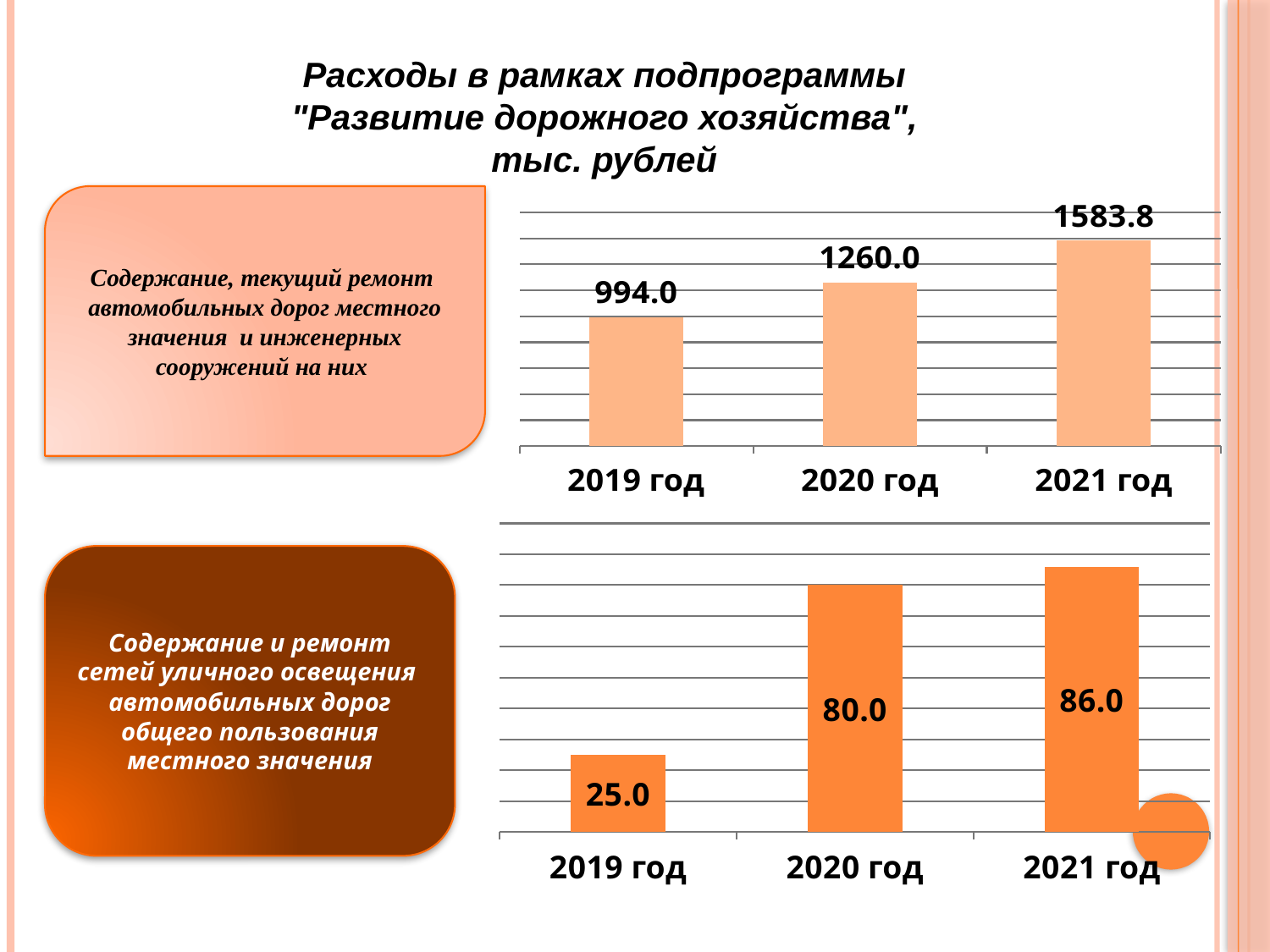
In the top chart, what is the difference between the values for 2021 год and 2020 год? 323.8 In the bottom chart, do the values rise or fall from 2019 год to 2021 год? rise In the bottom chart, which year has the lowest value? 2019 год In the top chart, which year has the highest value? 2021 год How many bars are in the bottom chart? 3 In the top chart, which is larger, the value for 2019 год or the value for 2020 год? 2020 год In the bottom chart, what is the value for 2019 год? 25.0 In the top chart, what is the value for 2019 год? 994.0 In the top chart, what is the value for 2021 год? 1583.8 In the bottom chart, what is the difference between the values for 2020 год and 2019 год? 55.0 What kind of chart is the top chart? bar chart In the bottom chart, what is the value for 2020 год? 80.0